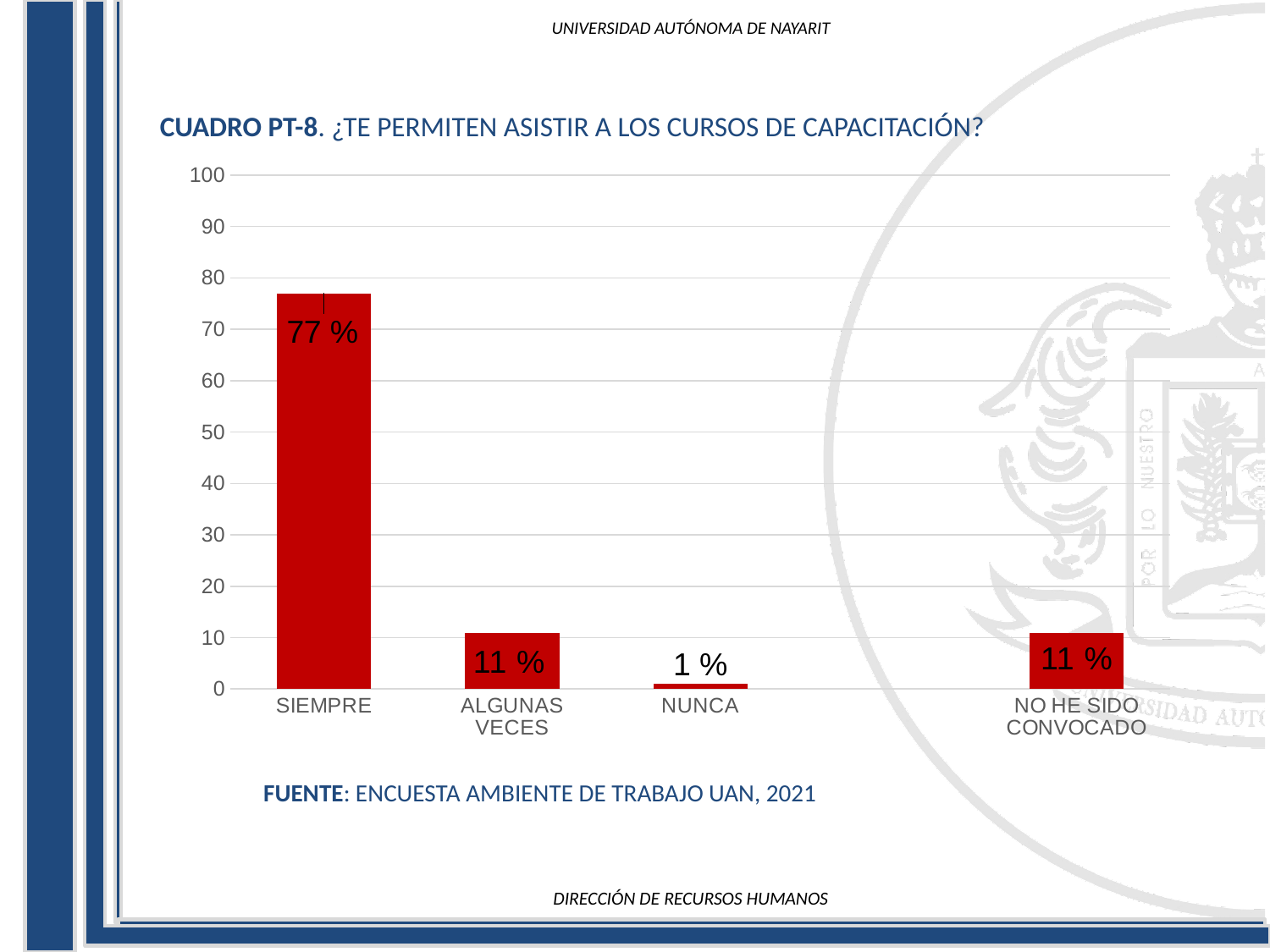
How many categories are shown on the x axis? 4 What kind of chart is shown on the slide? bar chart Which category has the highest value? SIEMPRE Is the value for SIEMPRE greater or less than 70? greater What is the value for SIEMPRE? 77 % Which is larger, the value for SIEMPRE or the value for NUNCA? SIEMPRE What is the difference between the values for NO HE SIDO CONVOCADO and NUNCA? 10 % What is the difference between the values for SIEMPRE and ALGUNAS VECES? 66 % What is the value for NUNCA? 1 % What is the value for NO HE SIDO CONVOCADO? 11 % What is the value for ALGUNAS VECES? 11 % Which category has the lowest value? NUNCA